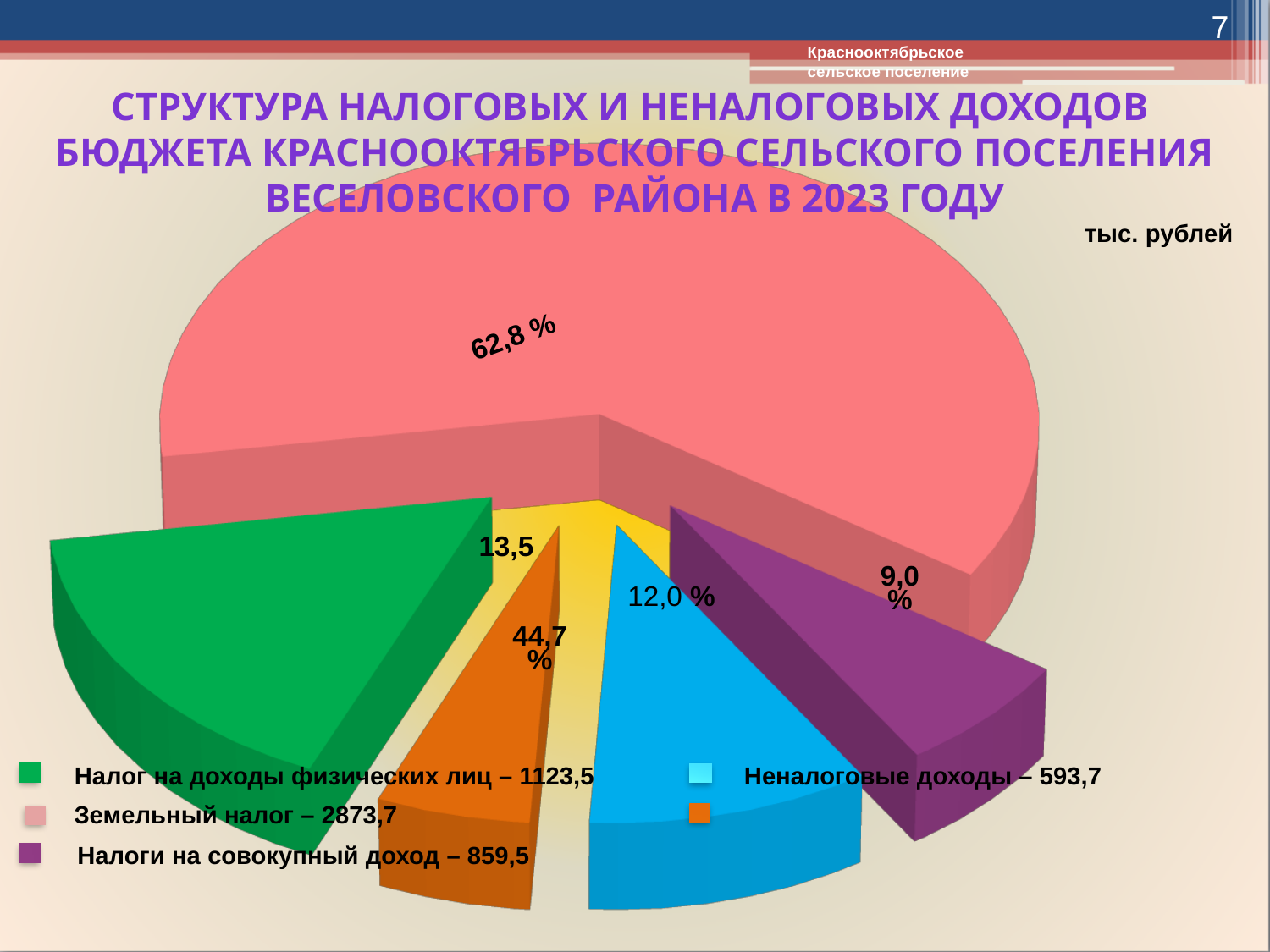
What is the value for Налог на доходы физических лиц? 1123,5 What is the value for Земельный налог? 2873,7 What is the difference between Земельный налог and Налог на доходы физических лиц? 1750,2 What is the difference between Налоги на совокупный доход and Неналоговые доходы? 265,8 What colour is the slice for Земельный налог? pink What share of the pie does Земельный налог take? 62,8 % In what units are the values on the chart given? тыс. рублей What is the value for Налоги на совокупный доход? 859,5 Which is larger: Налог на доходы физических лиц or Неналоговые доходы? Налог на доходы физических лиц What is the value for Неналоговые доходы? 593,7 Which category has the largest slice of the pie? Земельный налог What kind of chart is shown on the slide? pie chart